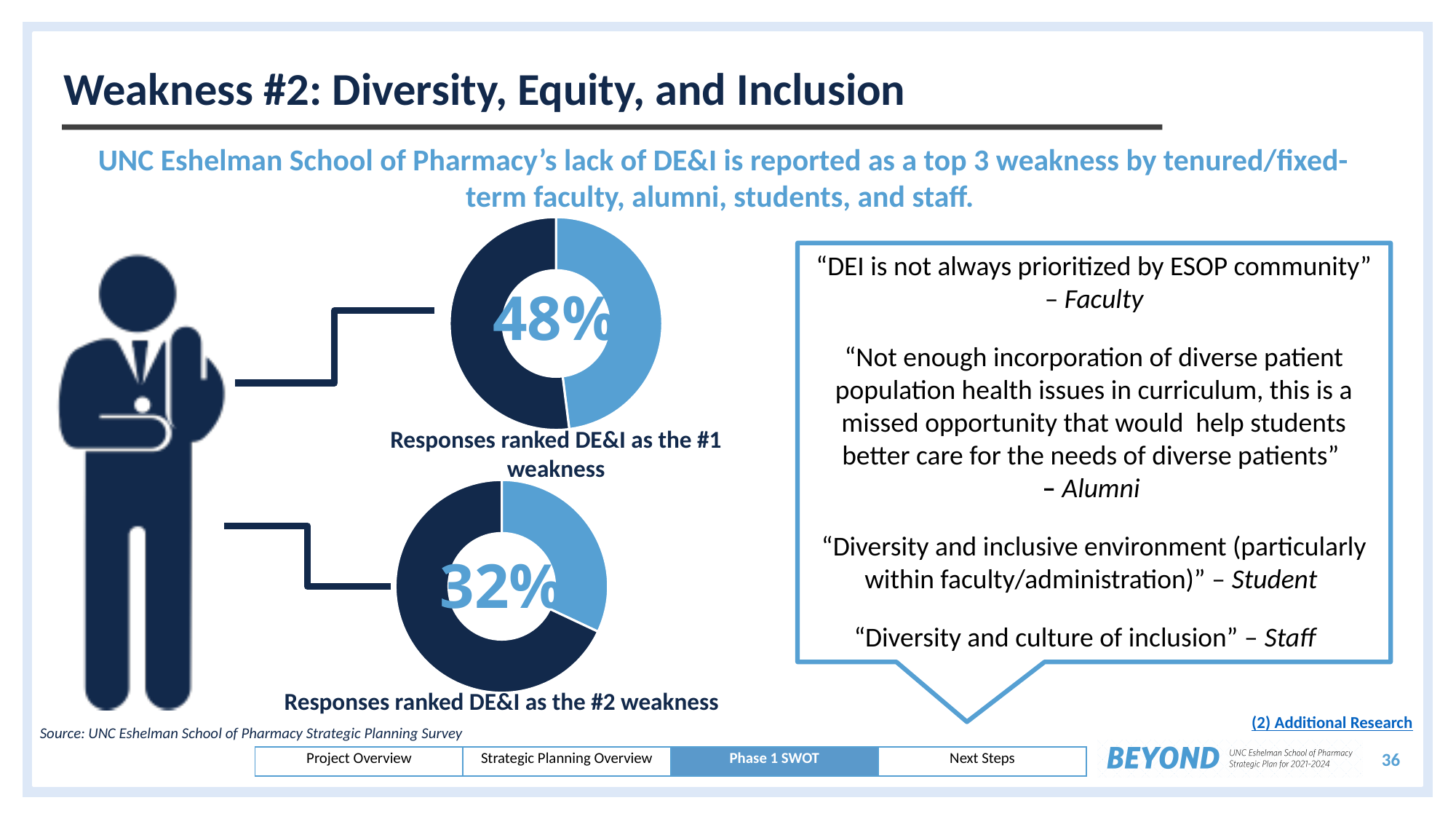
What colour is the slice representing the highlighted percentage in each donut chart? Light blue What is the caption below the bottom donut chart? Responses ranked DE&I as the #2 weakness In the top donut chart, is the share of responses ranking DE&I as the #1 weakness greater or less than 50%? less What percentage is shown in the centre of the bottom donut chart, labelled "Responses ranked DE&I as the #2 weakness"? 32% In the top donut chart, what share of the ring does the light blue slice represent? 48% In the bottom donut chart, is the share of responses ranking DE&I as the #2 weakness greater or less than 25%? greater What percentage is shown in the centre of the top donut chart, labelled "Responses ranked DE&I as the #1 weakness"? 48% How many donut charts are shown on the slide? 2 What kind of chart is used to show the share of responses ranking DE&I as the #1 weakness? Donut (pie) chart Which is larger: the share of responses ranking DE&I as the #1 weakness or the share ranking it as the #2 weakness? #1 weakness (48%) In the bottom donut chart, what share of the ring does the light blue slice represent? 32% What is the difference in percentage points between the share ranking DE&I as the #1 weakness (48%) and the share ranking it as the #2 weakness (32%)? 16 percentage points